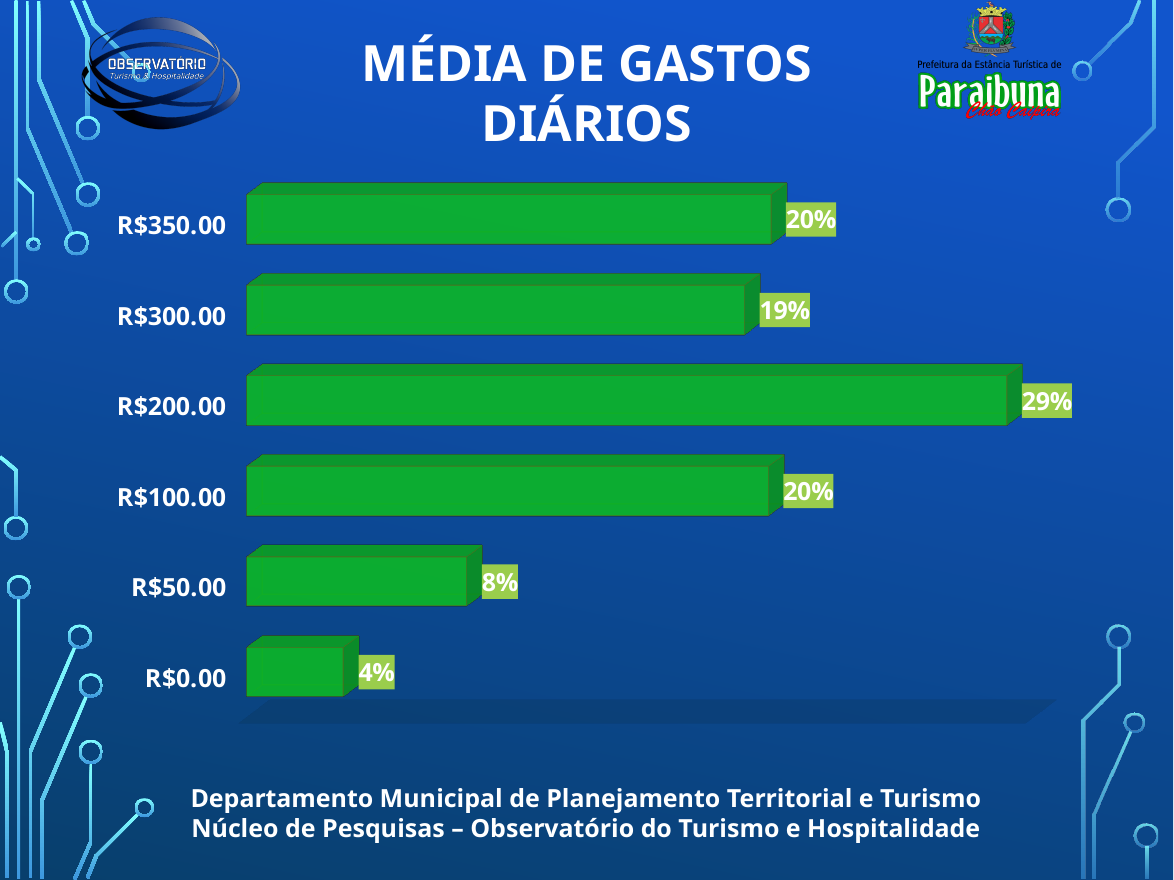
What is the difference between the values for R$50.00 and R$0.00? 4% What is the title of the chart? MÉDIA DE GASTOS DIÁRIOS What kind of chart is shown on the slide? Bar chart Which is larger, the value for R$100.00 or the value for R$50.00? R$100.00 What is the value for R$300.00? 19% Which category has the lowest value? R$0.00 Which category has the highest value? R$200.00 What is the difference between the values for R$200.00 and R$300.00? 10% What is the value for R$50.00? 8% What is the value for R$200.00? 29% What colour are the bars in the chart? Green How many categories are shown in the chart? 6